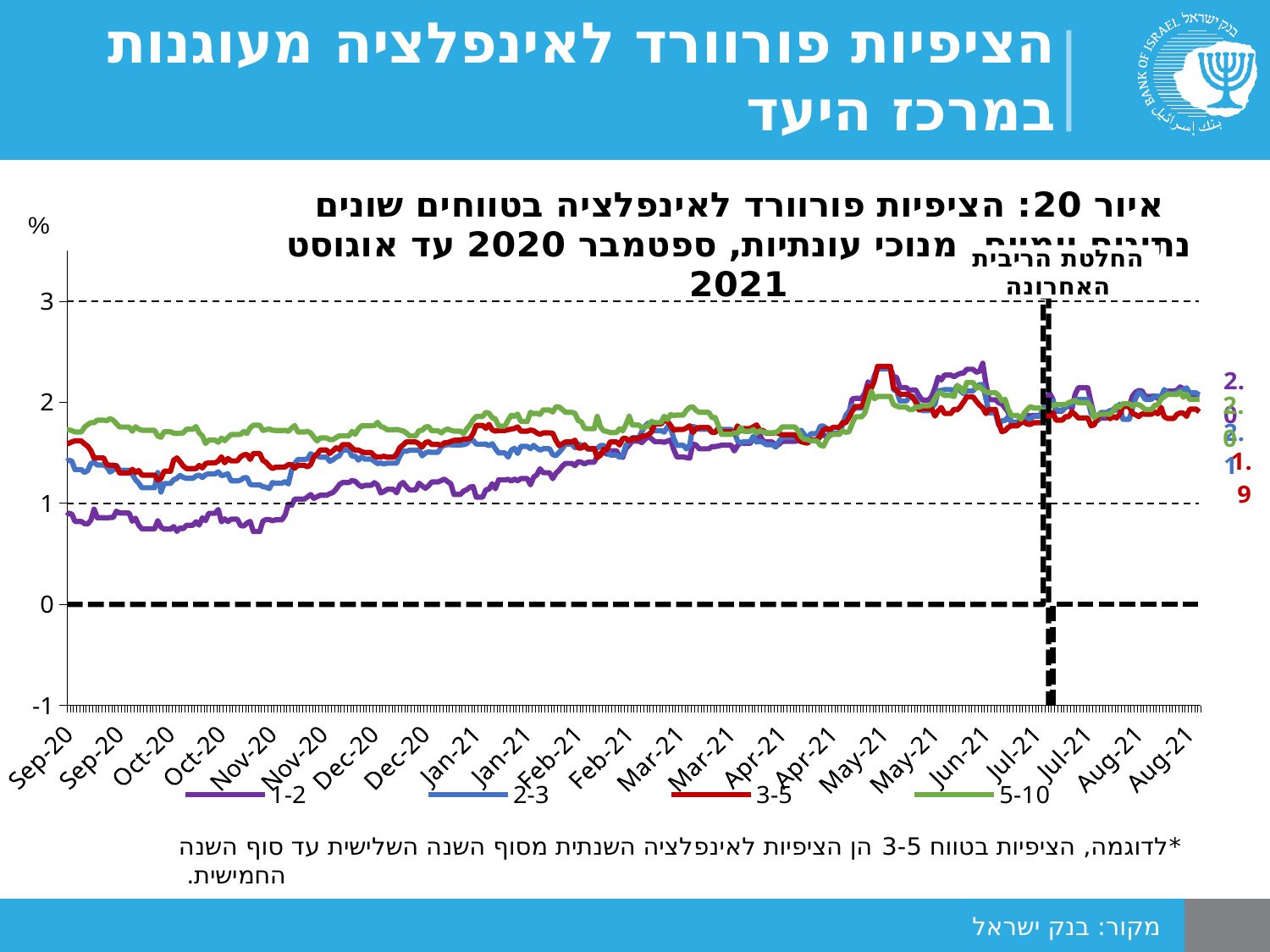
What unit is shown on the y axis? % Is the value of the 1-2 series in Oct-20 greater or less than 1? less Which series has the highest value at the start of the chart (Sep-20)? 5-10 What kind of chart is shown on the slide? line chart Which series has the lowest value at the start of the chart (Sep-20)? 1-2 How many series does the legend list? 4 Is the value of the 5-10 series in Nov-20 greater or less than 1? greater Is any series above 3 at any point on the chart? no Does the 1-2 series rise or fall overall from Sep-20 to Aug-21? rise In Nov-20, which series is higher: 1-2 or 5-10? 5-10 What are the four series listed in the legend? 1-2, 2-3, 3-5, 5-10